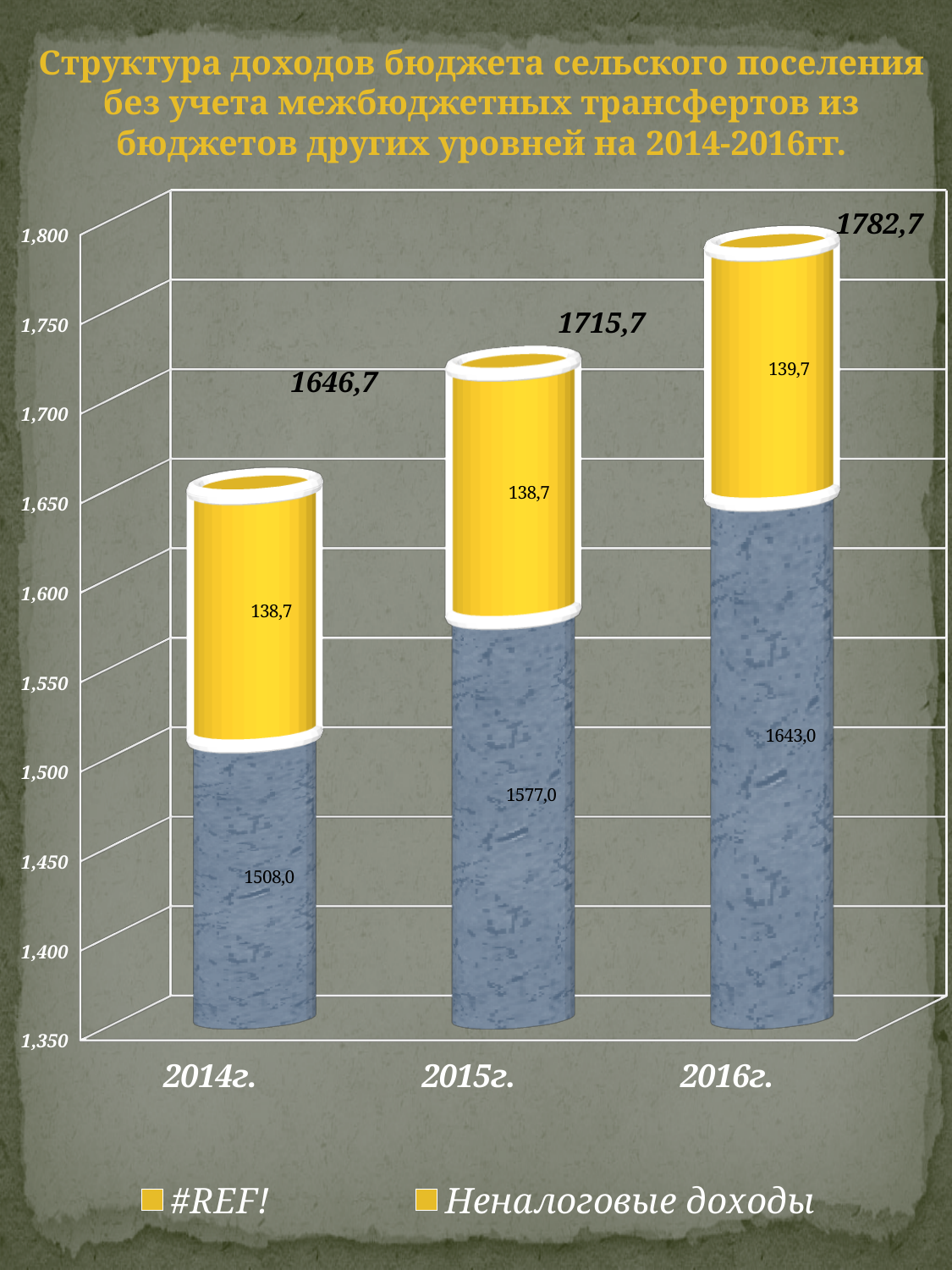
What is the difference between the total for 2016г. and the total for 2014г.? 136,0 What is the value of the yellow (upper) segment for 2015г.? 138,7 What is the value of the yellow (upper) segment for 2016г.? 139,7 How many years (categories) are shown on the x axis? 3 What is the value of the grey (lower) segment for 2014г.? 1508,0 How many entries does the legend list? 2 What kind of chart is shown on the slide? bar chart Do the total values rise or fall from 2014г. to 2016г.? rise What is the total value printed above the bar for 2016г.? 1782,7 Which year has the highest total value? 2016г. Is the total value for 2015г. greater or less than 1,700? greater Which year has the lowest total value? 2014г.